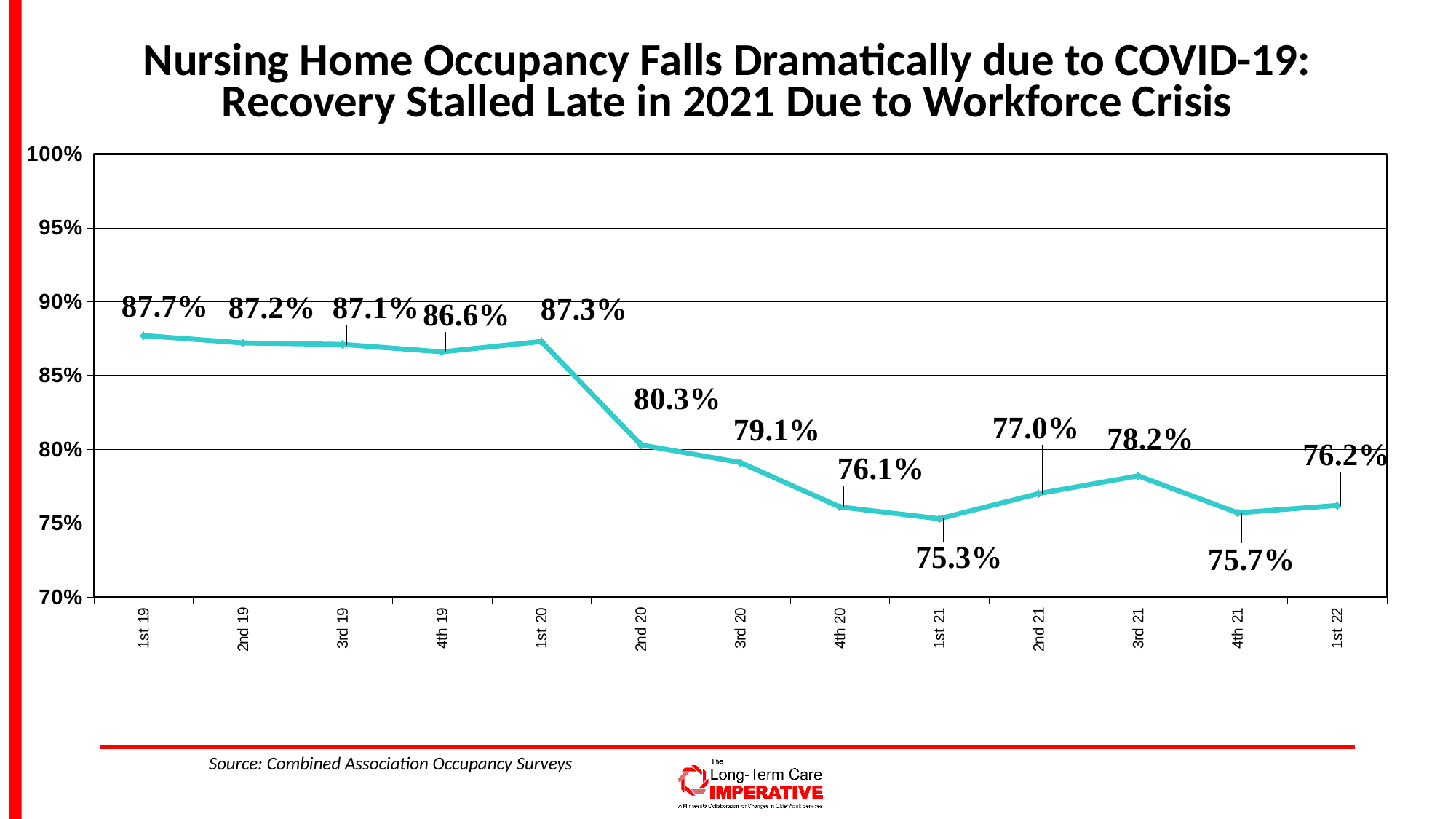
Which period has the highest occupancy value? 1st 19 How many data points are plotted on the chart? 13 Does the occupancy value rise or fall between 1st 20 and 1st 21? Fall What is the occupancy value for 1st 19? 87.7% What is the difference in percentage points between the values for 1st 20 and 2nd 20? 7.0 percentage points Which is larger, the value for 2nd 21 or the value for 4th 21? 2nd 21 What is the occupancy value for 2nd 20? 80.3% Which period has the lowest occupancy value? 1st 21 What is the difference in percentage points between the values for 1st 19 and 1st 22? 11.5 percentage points What is the occupancy value for 3rd 21? 78.2% What is the occupancy value for 1st 22? 76.2% What kind of chart is shown on the slide? Line chart